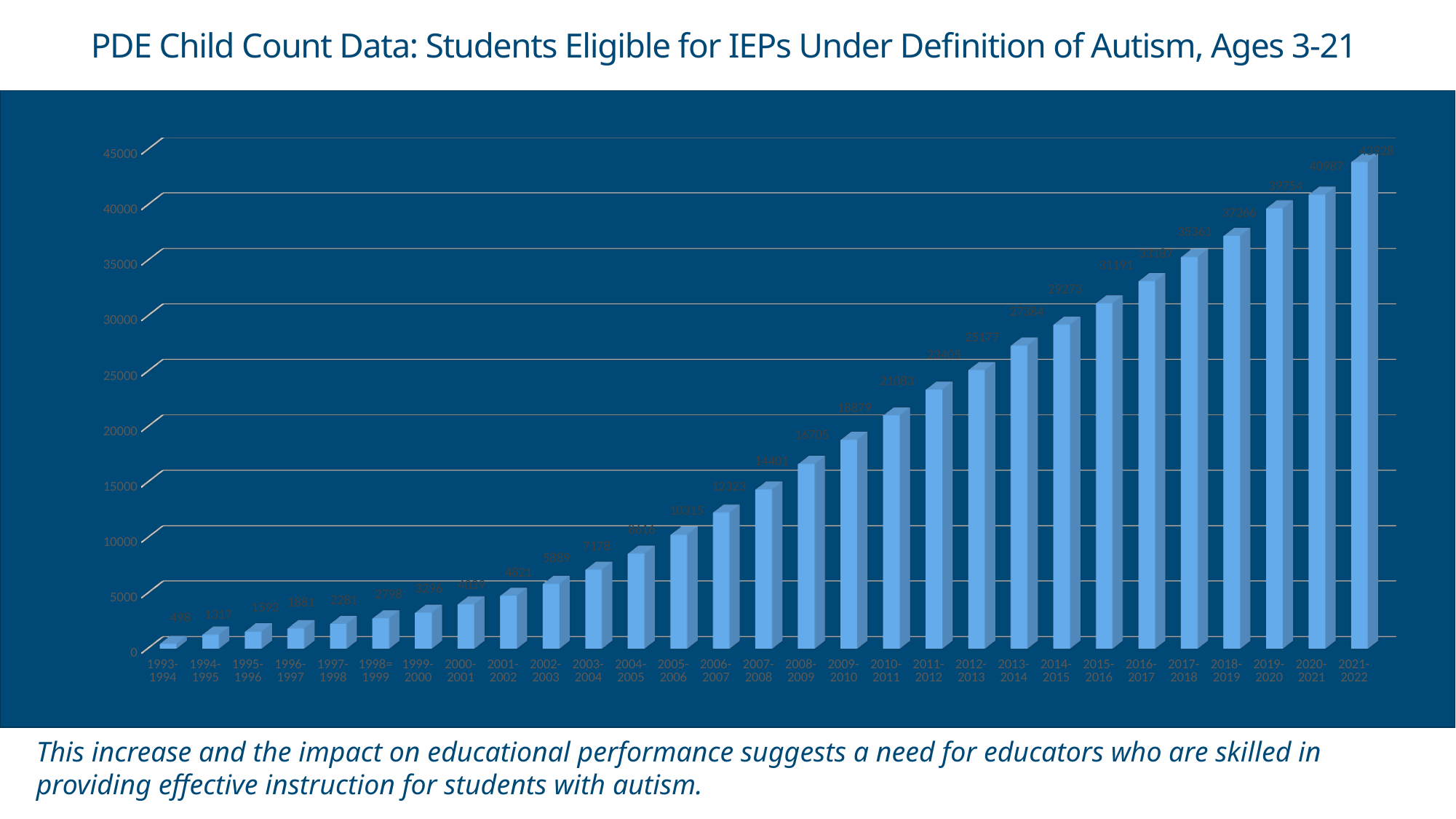
Do the values rise or fall from 1993-1994 to 2021-2022? rise Which is larger, the value for 2015-2016 or the value for 2009-2010? 2015-2016 Is the value for 2021-2022 greater or less than 40000? greater What is the difference between the values for 2005-2006 and 1993-1994? 9817 How many school years are plotted on the chart? 29 What is the value for 2005-2006? 10315 Which school year has the highest value? 2021-2022 Which school year has the lowest value? 1993-1994 What is the value for 2017-2018? 35361 What is the value for 2010-2011? 21083 What is the value for 1993-1994? 498 What kind of chart is shown on the slide? bar chart